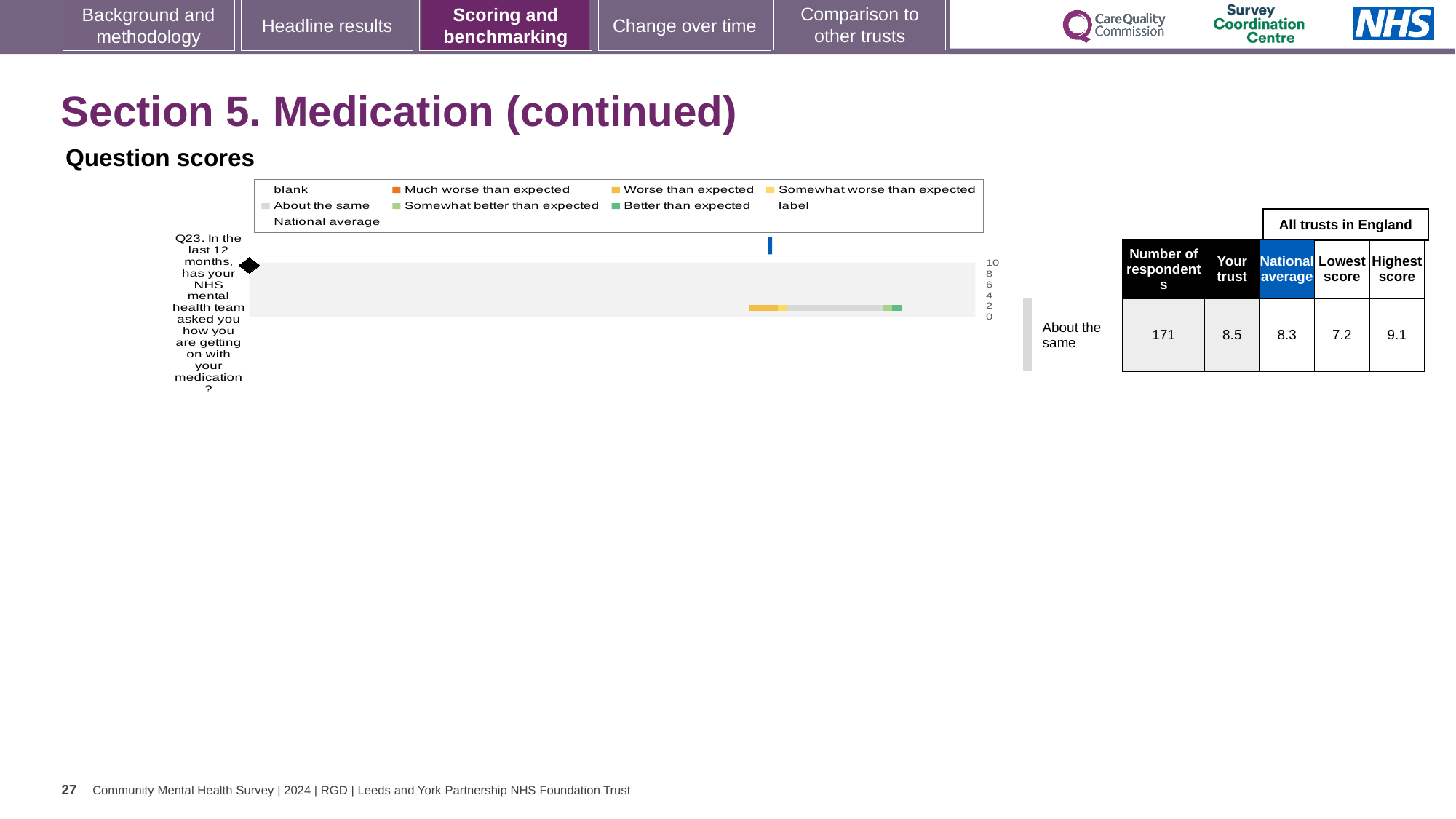
How many survey questions are plotted in the Question scores chart? 1 What is the national average score for Q23? 8.3 What is the highest score among all trusts in England for Q23? 9.1 How many respondents answered Q23? 171 What is the 'Your trust' score for Q23? 8.5 Which question is plotted in the Question scores chart? Q23. In the last 12 months, has your NHS mental health team asked you how you are getting on with your medication? What is the lowest score among all trusts in England for Q23? 7.2 Which benchmarking category is the trust's Q23 score placed in? About the same What is the difference between the 'Your trust' score and the national average for Q23? 0.2 For Q23, which is higher: the 'Your trust' score or the national average? Your trust What is the difference between the highest score and the lowest score for Q23? 1.9 What kind of chart is shown under 'Question scores'? bar chart